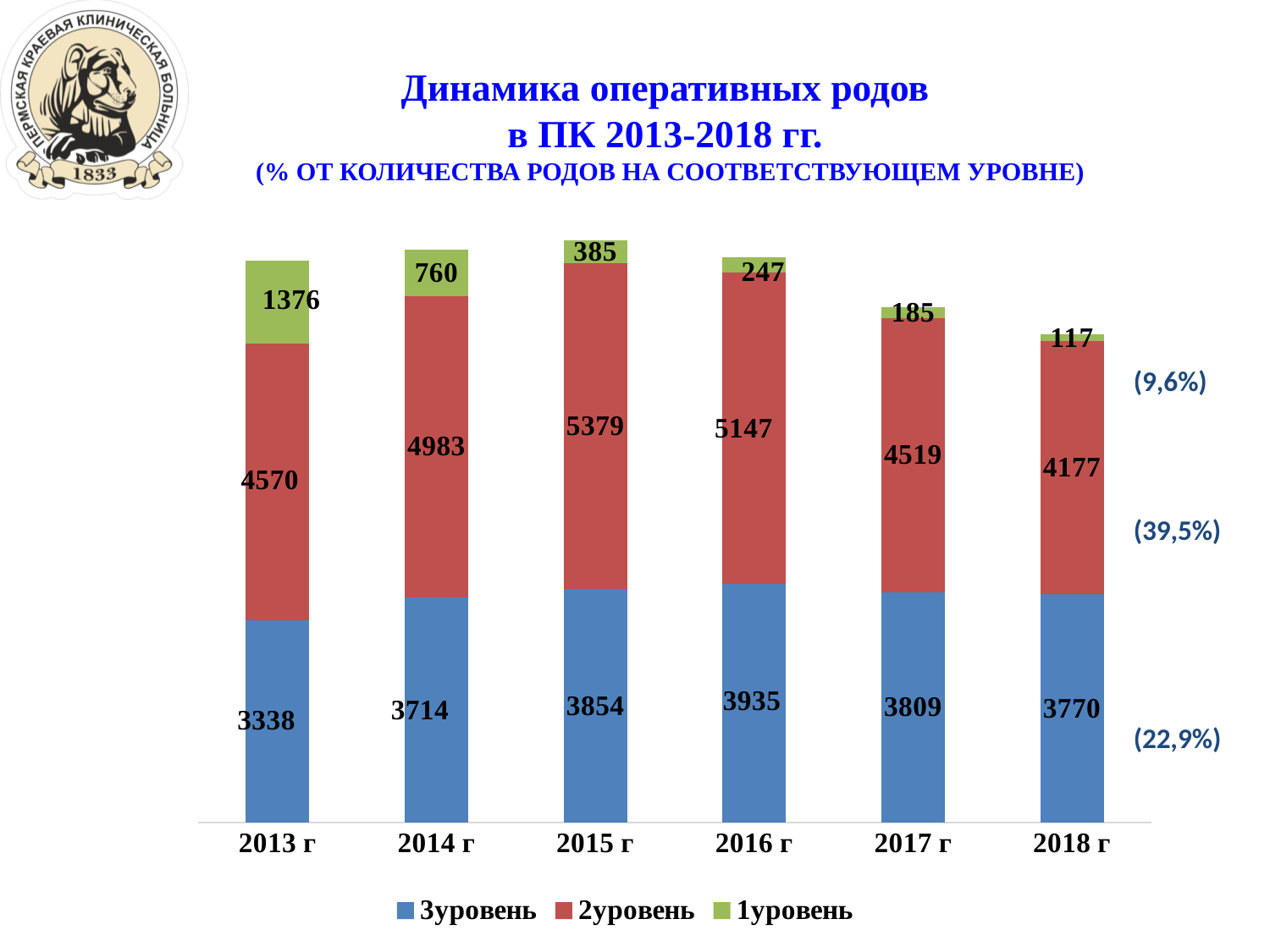
Which year has the highest value for 1уровень? 2013 г Which year has the lowest value for 3уровень? 2013 г What kind of chart is shown on the slide? stacked bar chart What is the total of the stacked bar for 2018 г? 8064 Which is larger, the 3уровень value for 2016 г or for 2017 г? 2016 г What is the value for 2уровень in 2015 г? 5379 What is the value for 3уровень in 2018 г? 3770 What is the difference between the 2уровень values for 2015 г and 2018 г? 1202 What is the value for 1уровень in 2013 г? 1376 How many series does the legend list? 3 How many years are shown on the x axis? 6 Does the value for 1уровень rise or fall from 2013 г to 2018 г? fall